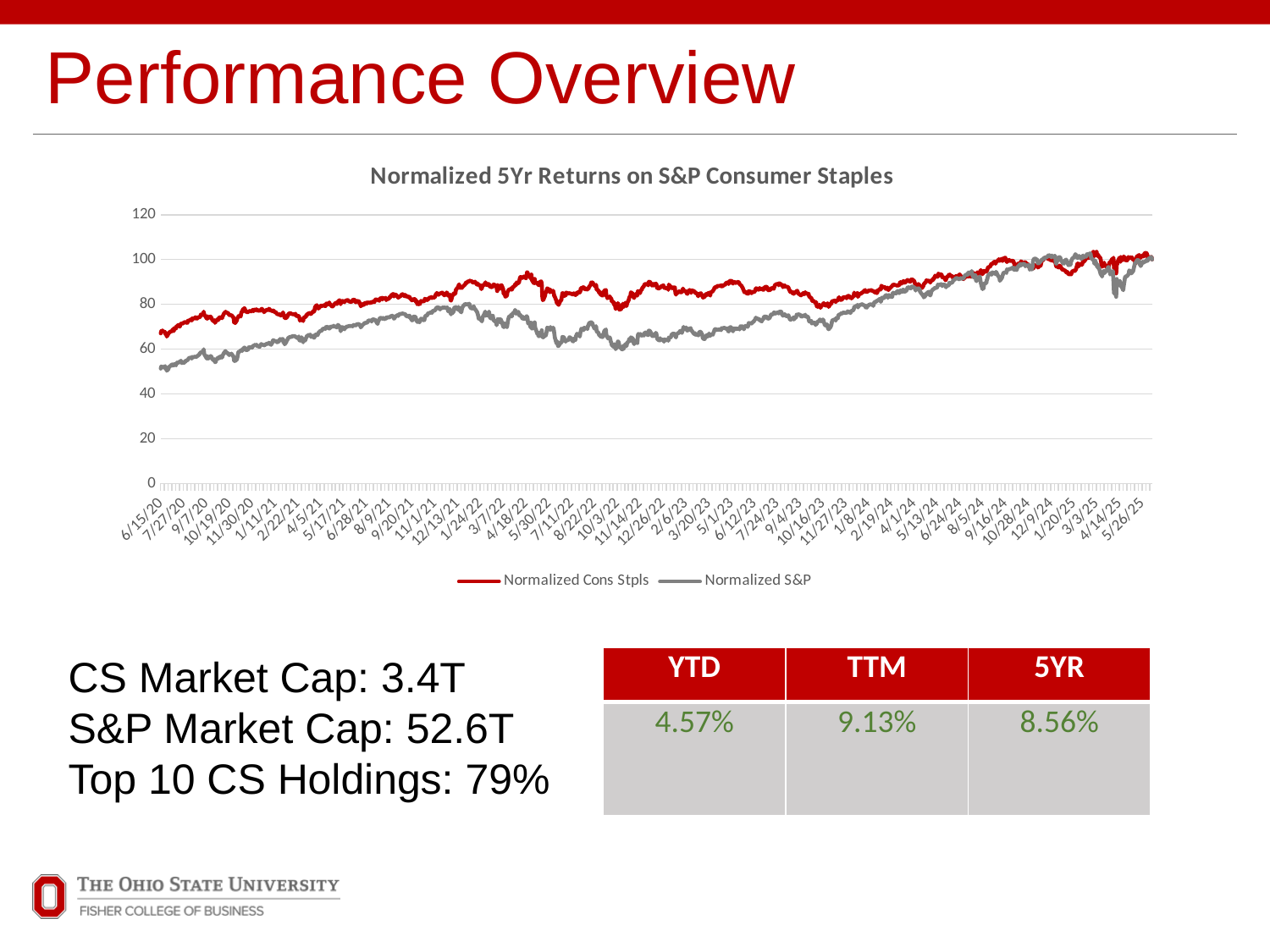
Is the value of Normalized S&P at 6/15/20 greater or less than 60? less What is the title of the chart? Normalized 5Yr Returns on S&P Consumer Staples Does the Normalized Cons Stpls series generally rise or fall over the period shown? Rise At the start of the chart (6/15/20), which series is higher: Normalized Cons Stpls or Normalized S&P? Normalized Cons Stpls What kind of chart is shown on the slide? Line chart Is the value of Normalized Cons Stpls at 6/15/20 greater or less than 60? greater How many series does the legend of the chart list? 2 Is the value of Normalized Cons Stpls at 5/26/25 greater or less than 80? greater Does the Normalized S&P series generally rise or fall from 6/15/20 to 5/26/25? Rise Around 10/3/22, which series is higher: Normalized Cons Stpls or Normalized S&P? Normalized Cons Stpls Which series is drawn in red in the chart? Normalized Cons Stpls